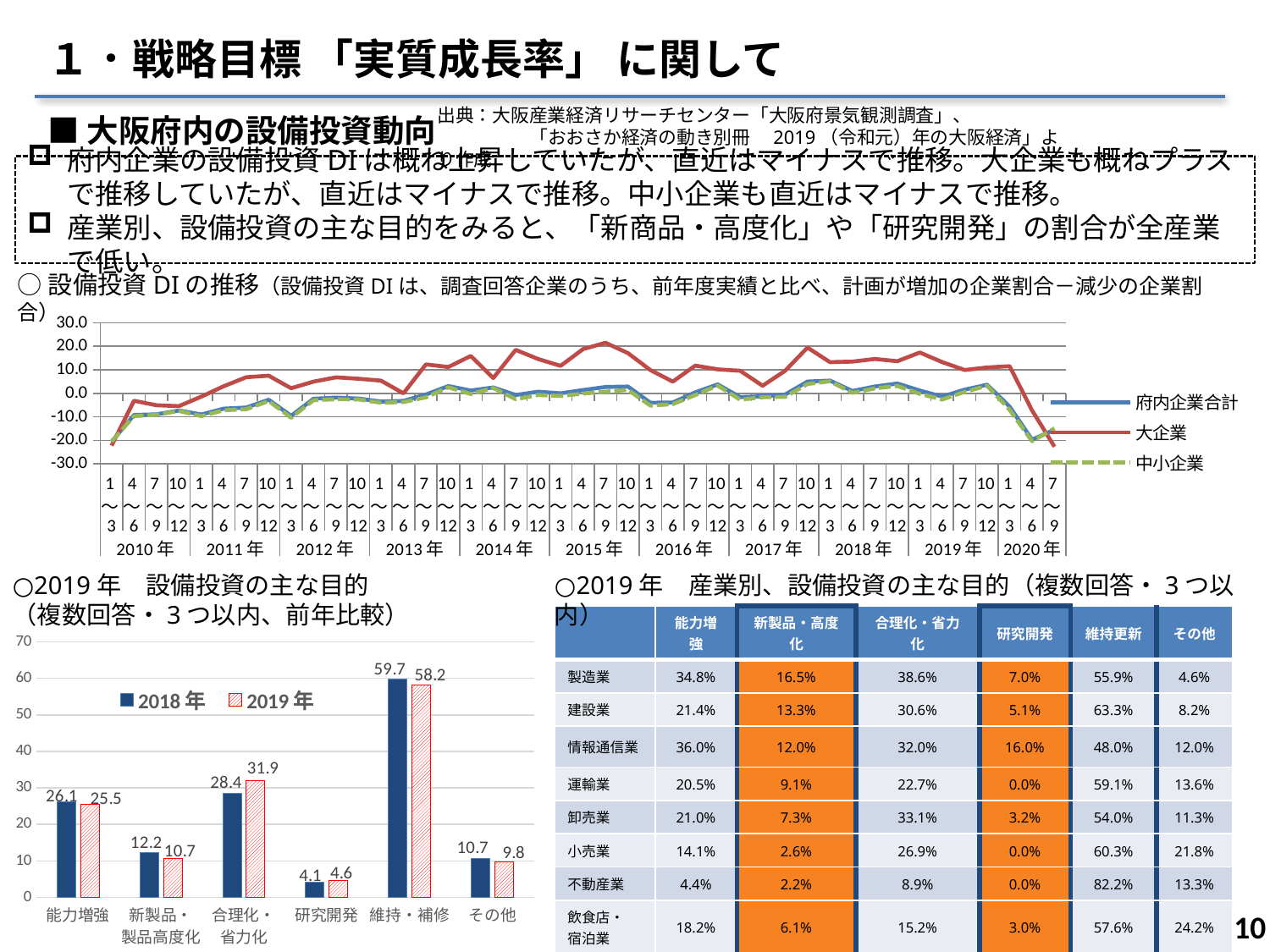
In the line chart titled 設備投資DIの推移, how many series does the legend list? 3 In the bar chart titled 2019年 設備投資の主な目的, which category has the highest value for 2019年? 維持・補修 In the bar chart titled 2019年 設備投資の主な目的, which category has the lowest value for 2018年? 研究開発 In the bar chart titled 2019年 設備投資の主な目的, how many categories are shown on the x axis? 6 In the line chart titled 設備投資DIの推移, is the value for 府内企業合計 at 2020年 7~9 greater or less than -10.0? less What kind of chart is the chart titled 設備投資DIの推移? Line chart In the bar chart titled 2019年 設備投資の主な目的, which is larger for 能力増強: the 2018年 value or the 2019年 value? 2018年 In the bar chart titled 2019年 設備投資の主な目的, what is the difference between the 2019年 and 2018年 values for 合理化・省力化? 3.5 In the bar chart titled 2019年 設備投資の主な目的, what is the value for 合理化・省力化 in 2019年? 31.9 In the bar chart titled 2019年 設備投資の主な目的, what is the value for 研究開発 in 2018年? 4.1 In the bar chart titled 2019年 設備投資の主な目的, what is the value for 維持・補修 in 2018年? 59.7 In the bar chart titled 2019年 設備投資の主な目的, how many series does the legend list? 2